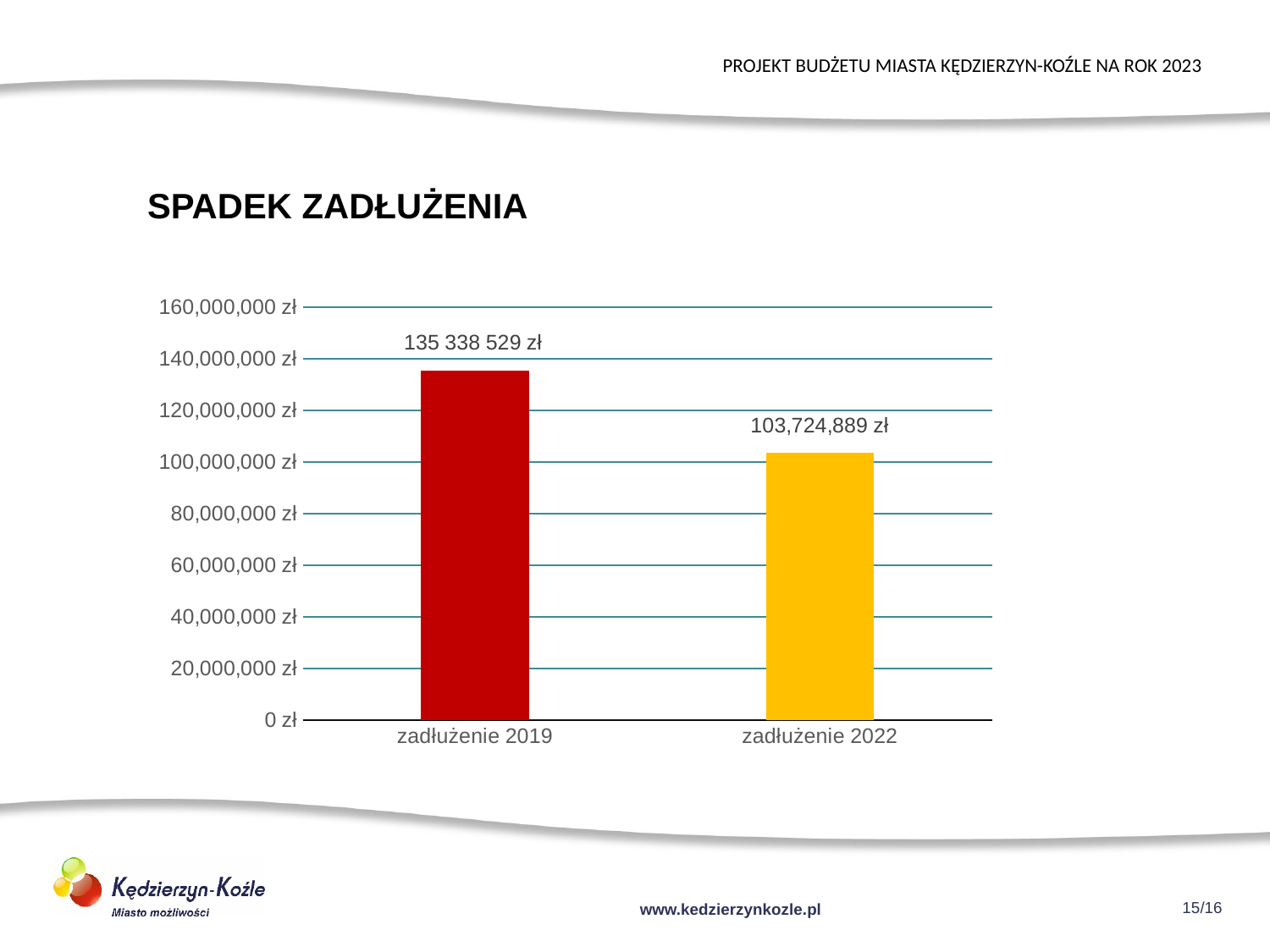
Is the value for zadłużenie 2022 greater or less than 120,000,000 zł? less Which category has the highest value? zadłużenie 2019 Which category has the lowest value? zadłużenie 2022 What kind of chart is shown on the slide? bar chart What is the value shown for zadłużenie 2019? 135 338 529 zł What is the difference between the value for zadłużenie 2019 and the value for zadłużenie 2022? 31,613,640 zł How many categories are shown on the chart? 2 Do the values rise or fall from zadłużenie 2019 to zadłużenie 2022? fall Which is larger, the value for zadłużenie 2019 or the value for zadłużenie 2022? zadłużenie 2019 What is the value shown for zadłużenie 2022? 103,724,889 zł Is the value for zadłużenie 2019 greater or less than 120,000,000 zł? greater What is the title of the chart on the slide? SPADEK ZADŁUŻENIA